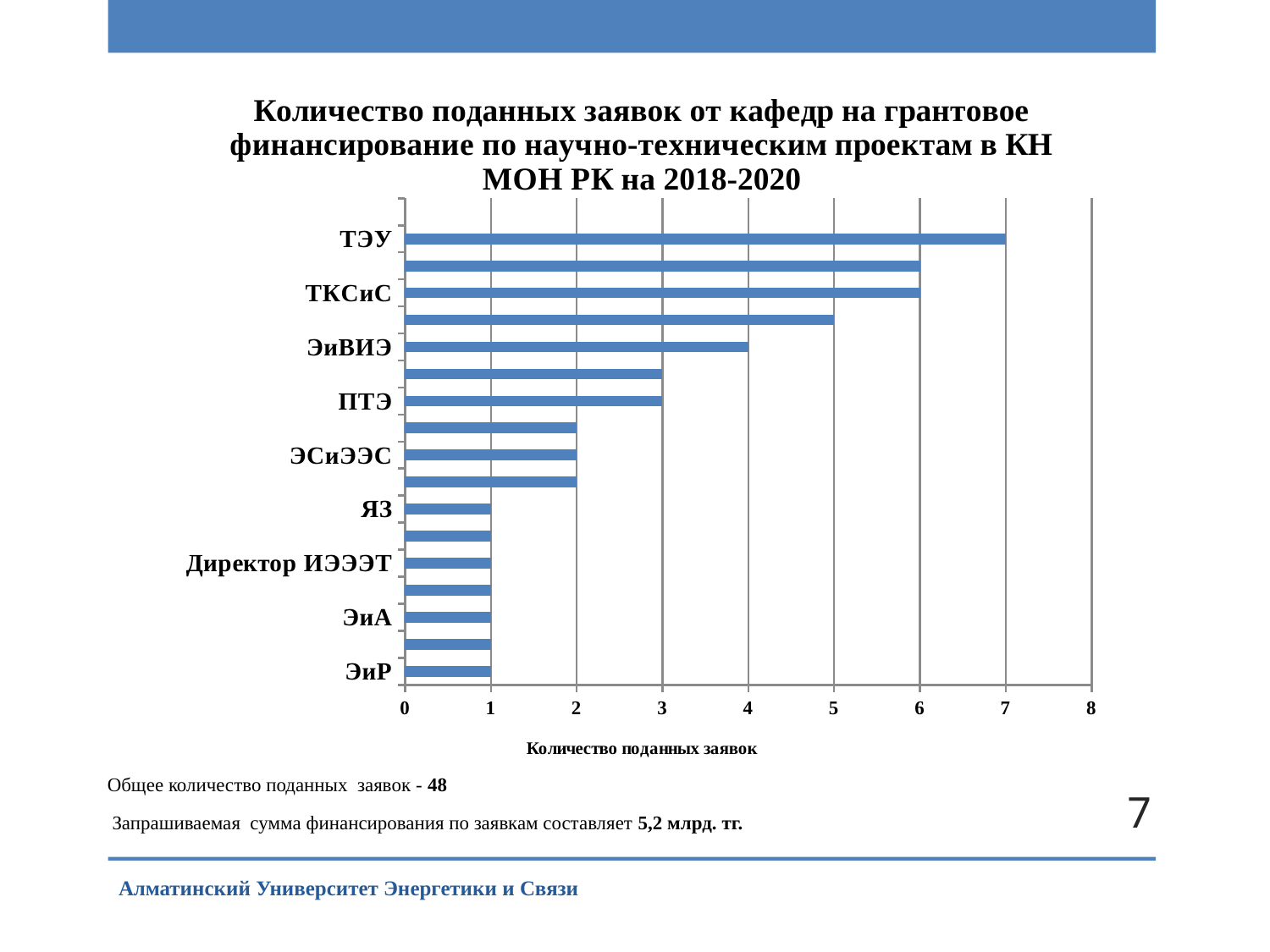
How many applications were submitted by ТЭУ? 7 What is the difference between the number of applications from ТЭУ and from ЭиВИЭ? 3 Is the value for ТЭУ greater or less than 5? greater How many applications were submitted by ЭСиЭЭС? 2 How many applications were submitted by ЭиВИЭ? 4 How many applications were submitted by ЭиР? 1 Which submitted more applications, ТКСиС or ПТЭ? ТКСиС How many applications were submitted by ПТЭ? 3 How many applications were submitted by ТКСиС? 6 What kind of chart is shown on the slide? bar chart Which labelled department submitted the most applications? ТЭУ What is the title of the horizontal axis of the chart? Количество поданных заявок